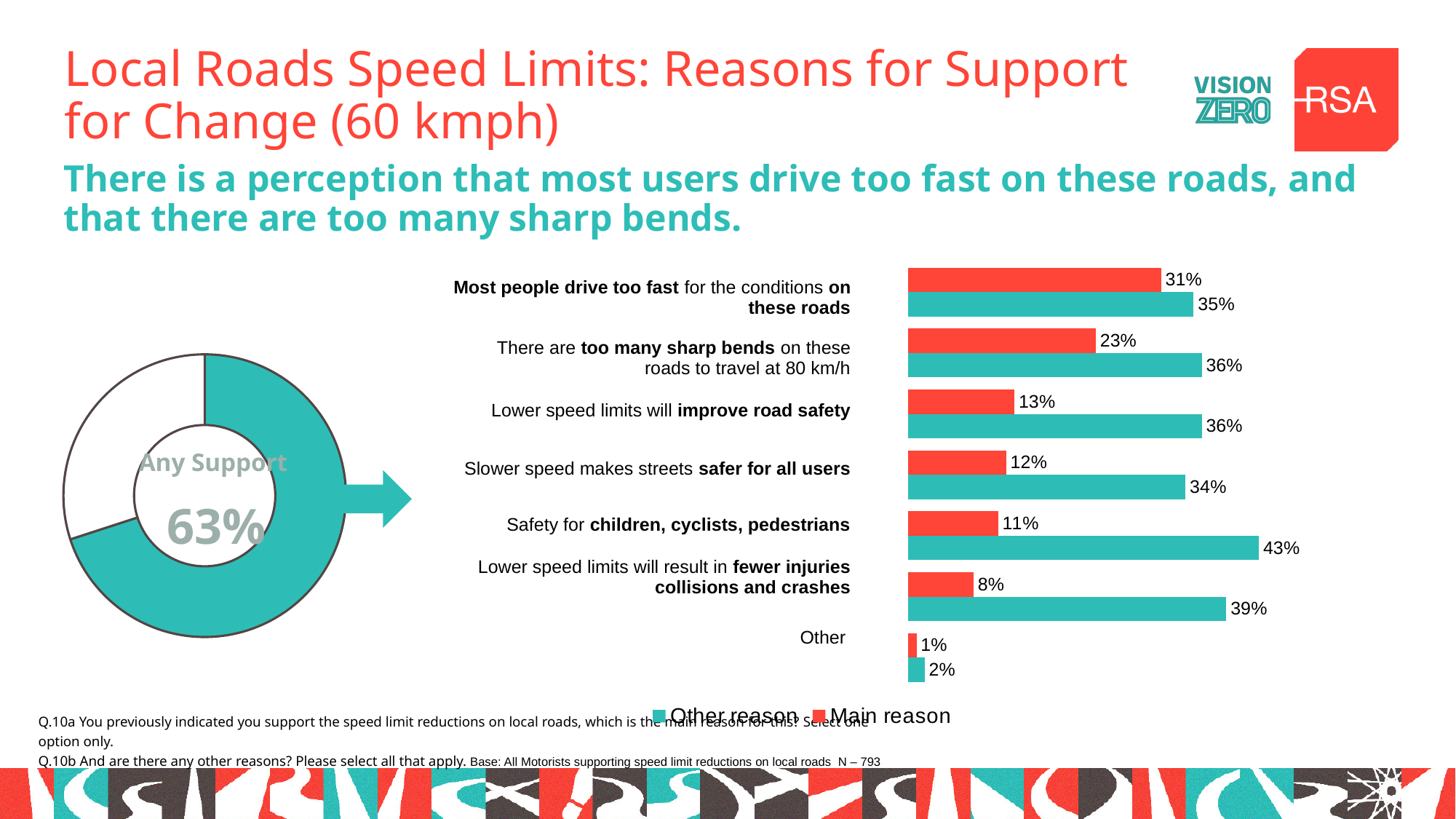
In the bar chart, which is larger for 'Slower speed makes streets safer for all users': the 'Main reason' value or the 'Other reason' value? Other reason In the bar chart, what is the 'Main reason' value for 'There are too many sharp bends on these roads to travel at 80 km/h'? 23% In the bar chart, what is the 'Other reason' value for 'Safety for children, cyclists, pedestrians'? 43% In the donut chart on the left, what percentage is shown for 'Any Support'? 63% How many categories are shown in the bar chart? 7 In the bar chart, what is the 'Main reason' value for 'Most people drive too fast for the conditions on these roads'? 31% In the bar chart, which category has the lowest 'Main reason' value? Other In the bar chart, what is the difference between the 'Other reason' and 'Main reason' values for 'Lower speed limits will result in fewer injuries collisions and crashes'? 31% In the bar chart, which category has the highest 'Other reason' value? Safety for children, cyclists, pedestrians How many series does the bar chart legend list? 2 What type of chart is used on the right side of the slide to show the reasons for support? Bar chart In the bar chart, which category has the highest 'Main reason' value? Most people drive too fast for the conditions on these roads